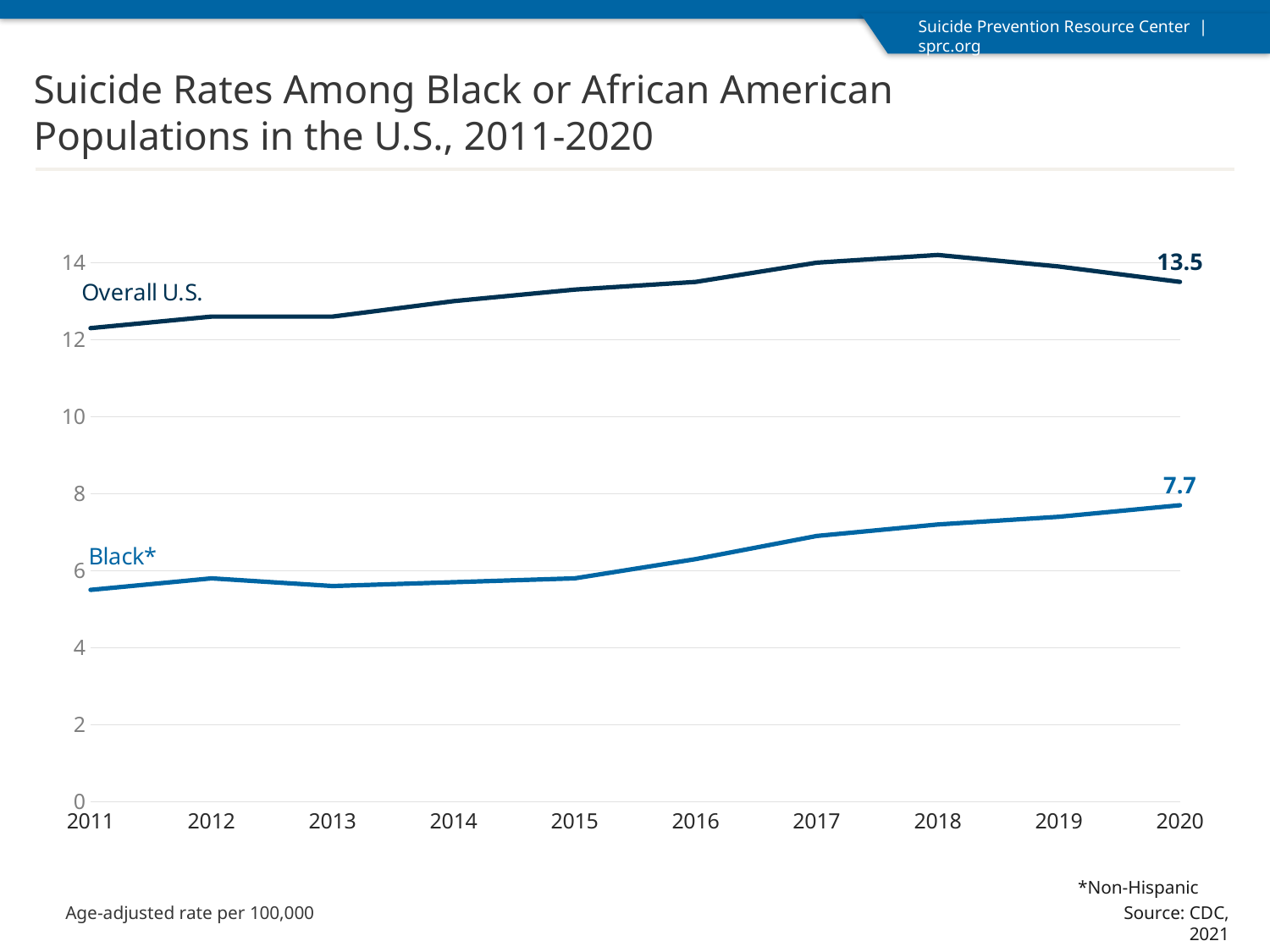
In which year does the Overall U.S. series reach its highest value? 2018 What is the suicide rate for the Overall U.S. series in 2020? 13.5 Is the value for the Overall U.S. series in 2011 greater or less than 12? greater Is the value for the Black* series in 2017 greater or less than 6? greater What kind of chart is shown on the slide? line chart How many years are shown on the x axis? 10 Does the Black* series rise or fall from 2011 to 2020? rise What is the difference between the Overall U.S. rate and the Black* rate in 2020? 5.8 How many series are plotted on the chart? 2 What is the suicide rate for the Black* series in 2020? 7.7 Is the value for the Black* series in 2011 greater or less than 6? less In 2020, which series has the higher rate, Overall U.S. or Black*? Overall U.S.